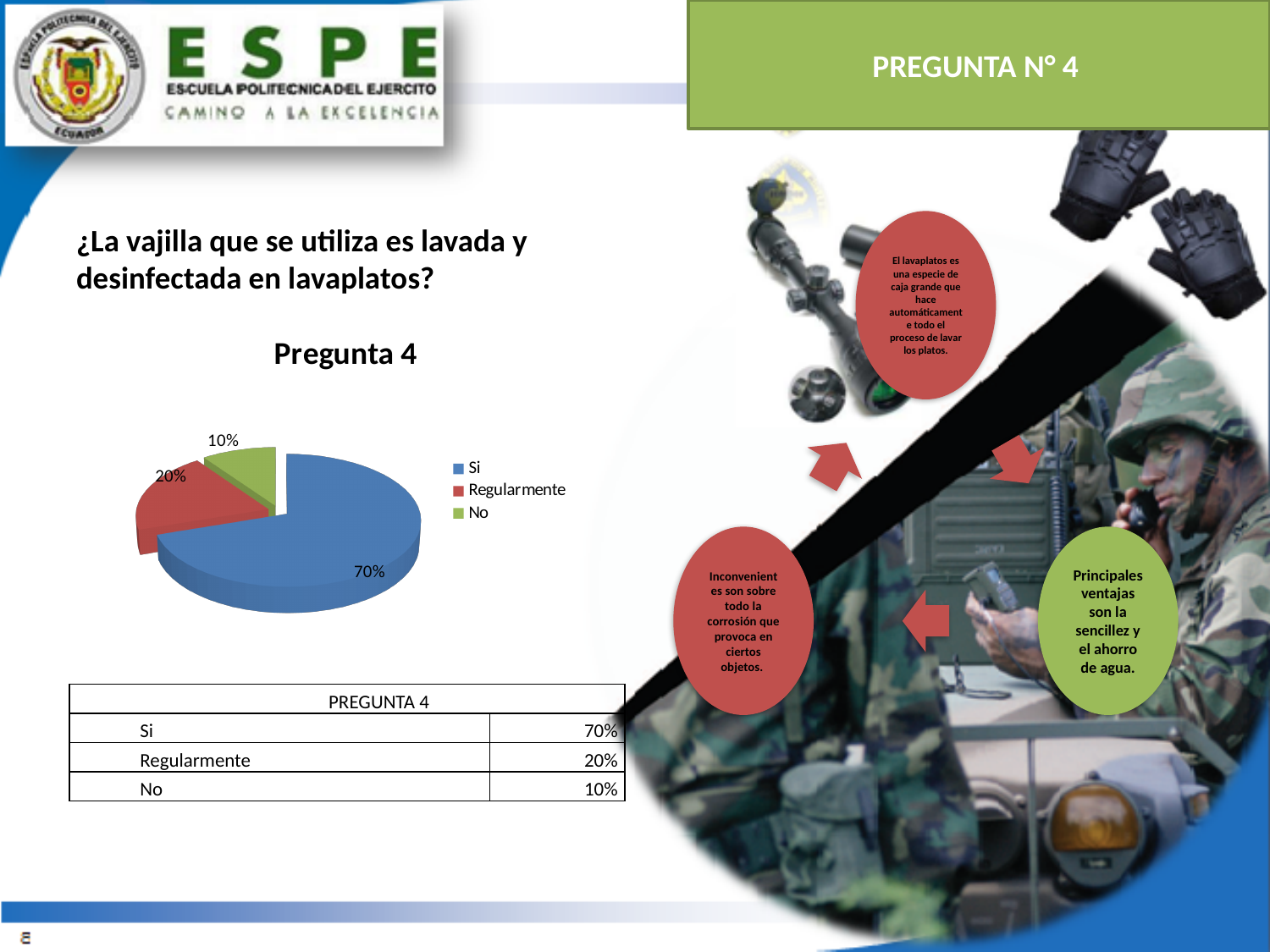
What is the value for "No" in the Pregunta 4 pie chart? 10% Which category has the smallest slice in the Pregunta 4 pie chart? No How many slices does the Pregunta 4 pie chart have? 3 What is the difference between the "Si" and "Regularmente" values in the Pregunta 4 pie chart? 50% What is the value for "Si" in the Pregunta 4 pie chart? 70% What type of chart is shown under the title "Pregunta 4"? pie chart Which category has the largest slice in the Pregunta 4 pie chart? Si In the Pregunta 4 pie chart, which is larger: "Regularmente" or "No"? Regularmente What colour is the "Si" slice in the Pregunta 4 pie chart? blue What is the difference between the "Regularmente" and "No" values in the Pregunta 4 pie chart? 10% What is the value for "Regularmente" in the Pregunta 4 pie chart? 20% How many entries does the legend of the Pregunta 4 pie chart list? 3